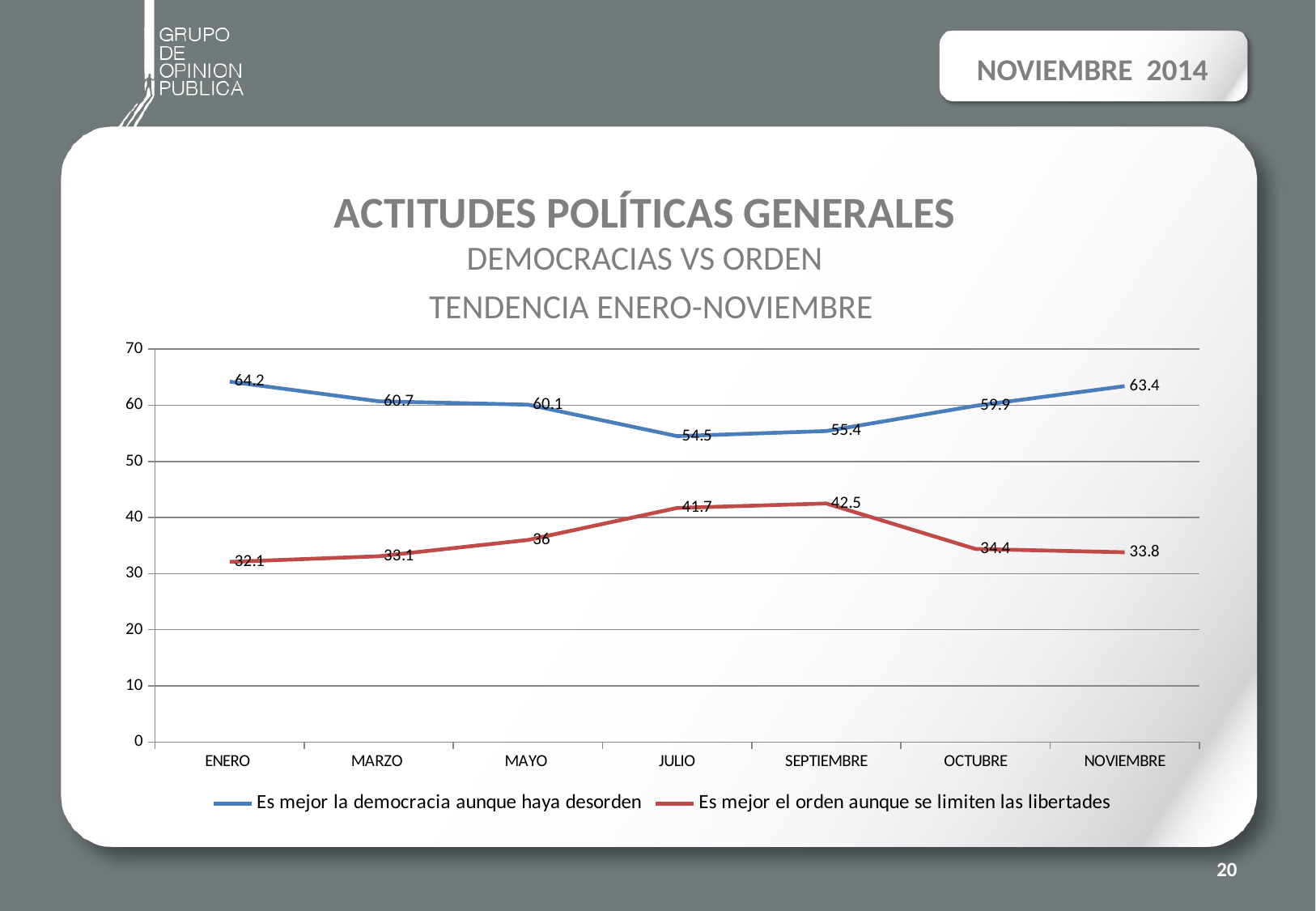
How many series does the legend list? 2 What is the difference between the two series in NOVIEMBRE? 29.6 Is the value for 'Es mejor el orden aunque se limiten las libertades' in JULIO greater or less than 40? greater In which month is 'Es mejor la democracia aunque haya desorden' lowest? JULIO Which series has the larger value in MAYO? Es mejor la democracia aunque haya desorden What is the value for 'Es mejor la democracia aunque haya desorden' in JULIO? 54.5 What kind of chart is shown on the slide? Line chart What is the value for 'Es mejor el orden aunque se limiten las libertades' in SEPTIEMBRE? 42.5 Does 'Es mejor la democracia aunque haya desorden' rise or fall from ENERO to JULIO? Fall How many months are shown on the x axis? 7 In which month is 'Es mejor el orden aunque se limiten las libertades' highest? SEPTIEMBRE What is the value for 'Es mejor la democracia aunque haya desorden' in ENERO? 64.2